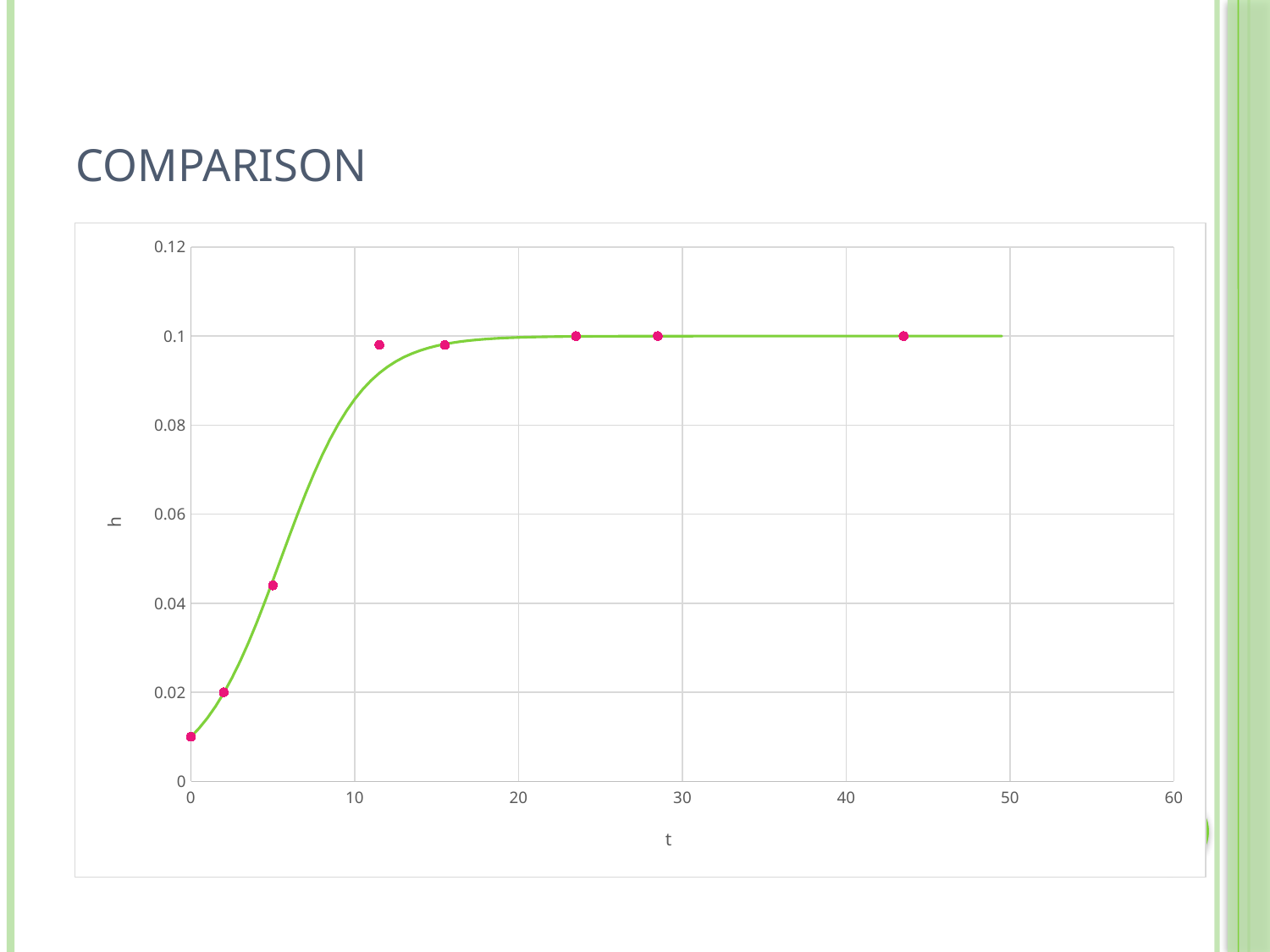
Is the value of the pink point near t = 5 greater or less than 0.06? less Is the value of the pink point at t = 0 greater or less than 0.02? less What are the labels of the x axis and y axis? t and h Do the values of h rise or fall as t increases from 0 to 10? Rise Which pink point has the larger h value, the one at t = 0 or the one near t = 5? The one near t = 5 Is the green curve at t = 20 greater or less than 0.08? greater Does the green curve keep rising or level off after t = 20? Level off What is the title of the slide containing the chart? COMPARISON What kind of chart is shown on the slide? Scatter chart with a fitted line How many pink data points are plotted on the chart? 8 At which t value is the lowest pink data point located? 0